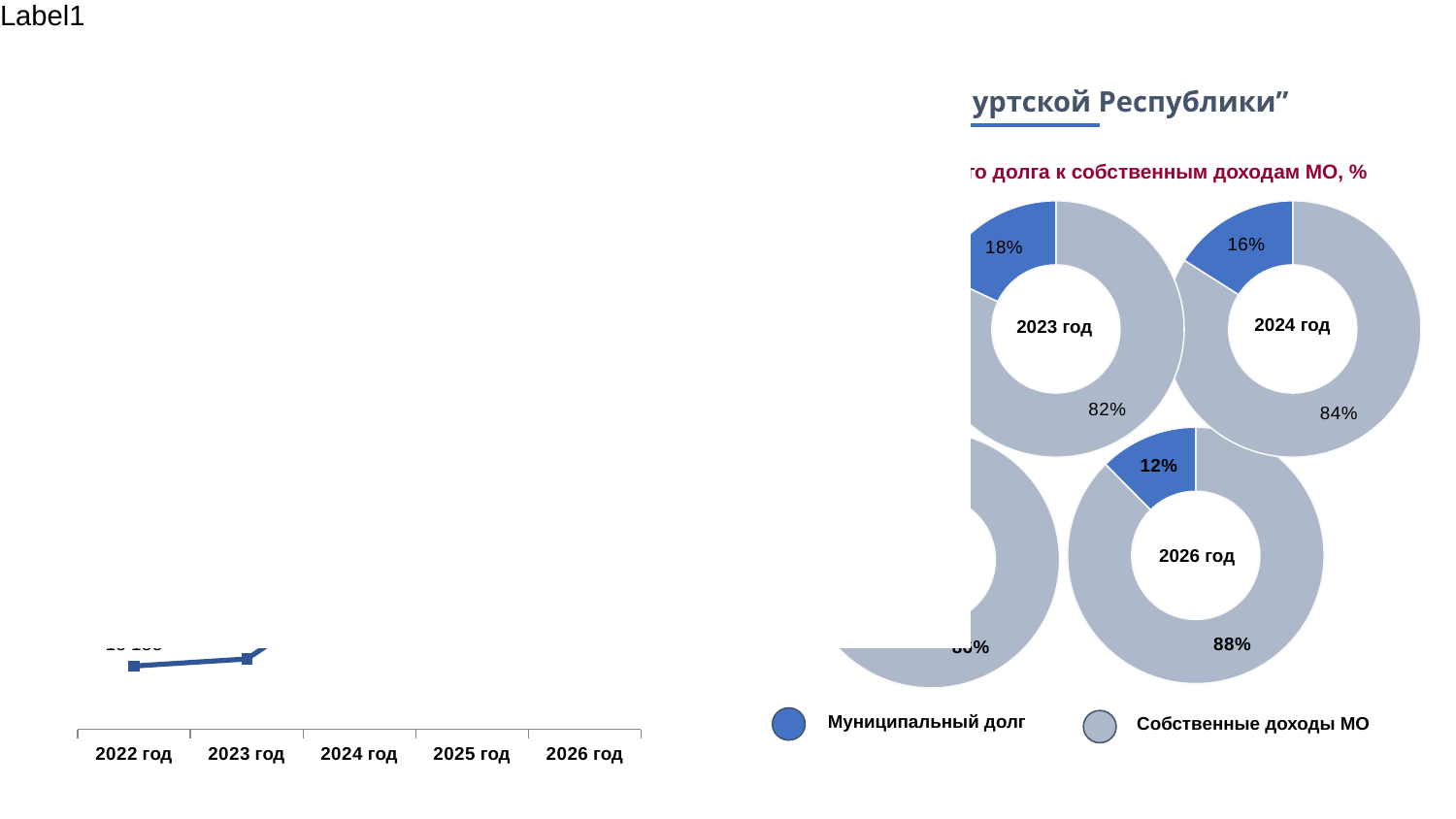
In the donut chart labelled 2023 год, what share is shown for Муниципальный долг? 18% In the donut chart labelled 2024 год, what share is shown for Муниципальный долг? 16% In the donut chart labelled 2023 год, what share is shown for Собственные доходы МО? 82% Which donut chart shows a larger share for Муниципальный долг: 2024 год or 2026 год? 2024 год By how many percentage points does the Муниципальный долг share in the 2023 год donut exceed that in the 2026 год donut? 6 In the donut chart labelled 2026 год, what share is shown for Собственные доходы МО? 88% How many entries does the legend below the donut charts list? 2 How many year categories are shown on the x axis of the chart on the left side of the slide? 5 Among the donut charts for 2023 год, 2024 год and 2026 год, which year shows the highest share for Муниципальный долг? 2023 год In the donut chart labelled 2024 год, what share is shown for Собственные доходы МО? 84% Among the donut charts for 2023 год, 2024 год and 2026 год, which year shows the lowest share for Муниципальный долг? 2026 год In the donut chart labelled 2026 год, what share is shown for Муниципальный долг? 12%